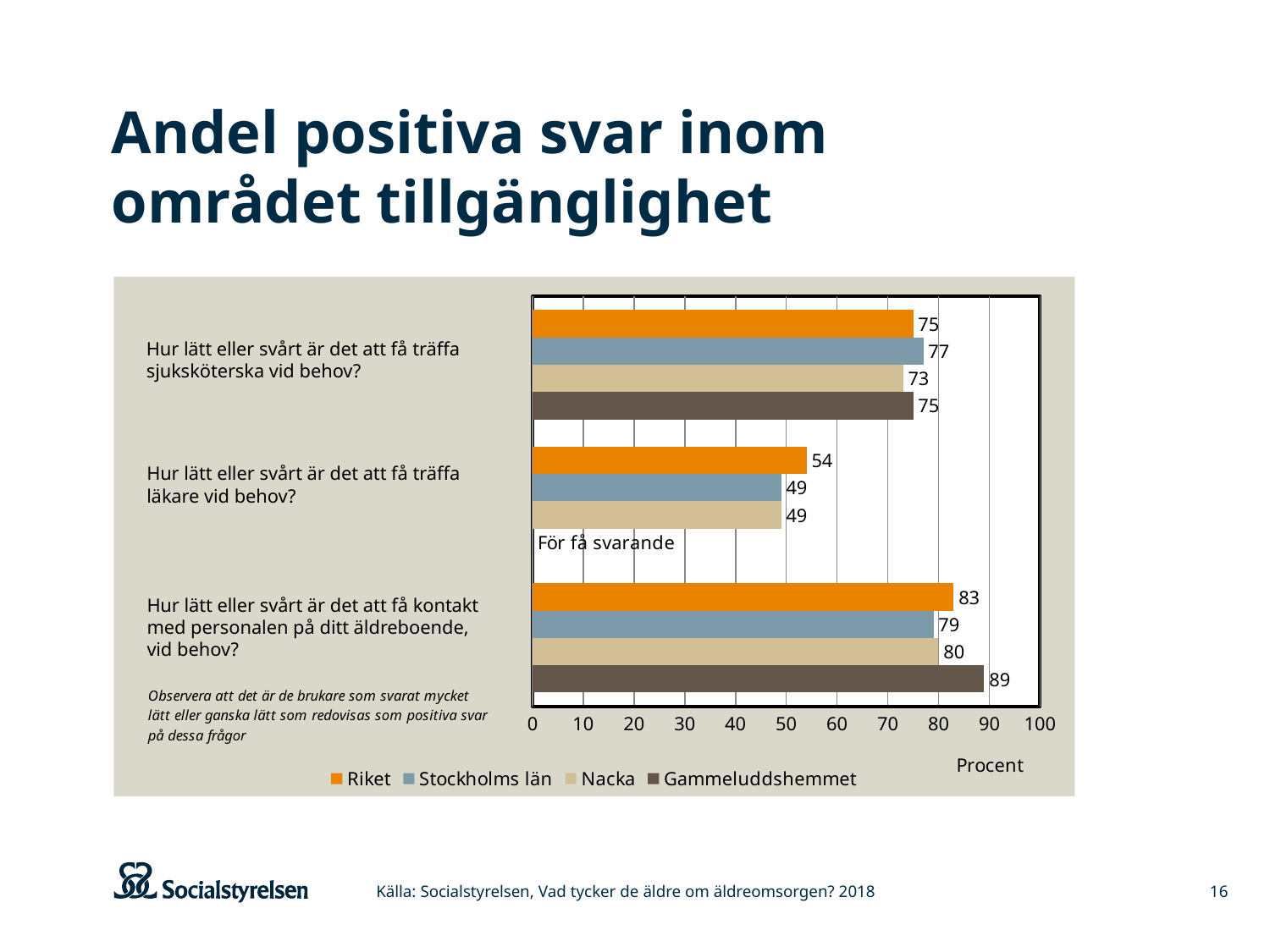
What is the difference between the Gammeluddshemmet and Riket values for the question "Hur lätt eller svårt är det att få kontakt med personalen på ditt äldreboende, vid behov?"? 6 Which series has the highest value for the question "Hur lätt eller svårt är det att få kontakt med personalen på ditt äldreboende, vid behov?"? Gammeluddshemmet What is the value for Nacka for the question "Hur lätt eller svårt är det att få träffa sjuksköterska vid behov?"? 73 What is the value for Stockholms län for the question "Hur lätt eller svårt är det att få träffa sjuksköterska vid behov?"? 77 How many series does the legend list? 4 What is shown instead of a bar for Gammeluddshemmet for the question "Hur lätt eller svårt är det att få träffa läkare vid behov?"? För få svarande What kind of chart is shown on the slide? bar chart What is the value for Riket for the question "Hur lätt eller svårt är det att få träffa läkare vid behov?"? 54 For the question "Hur lätt eller svårt är det att få träffa läkare vid behov?", which is larger, the value for Riket or the value for Stockholms län? Riket Which series has the lowest value for the question "Hur lätt eller svårt är det att få träffa sjuksköterska vid behov?"? Nacka What label is shown on the x axis of the chart? Procent What is the value for Gammeluddshemmet for the question "Hur lätt eller svårt är det att få kontakt med personalen på ditt äldreboende, vid behov?"? 89